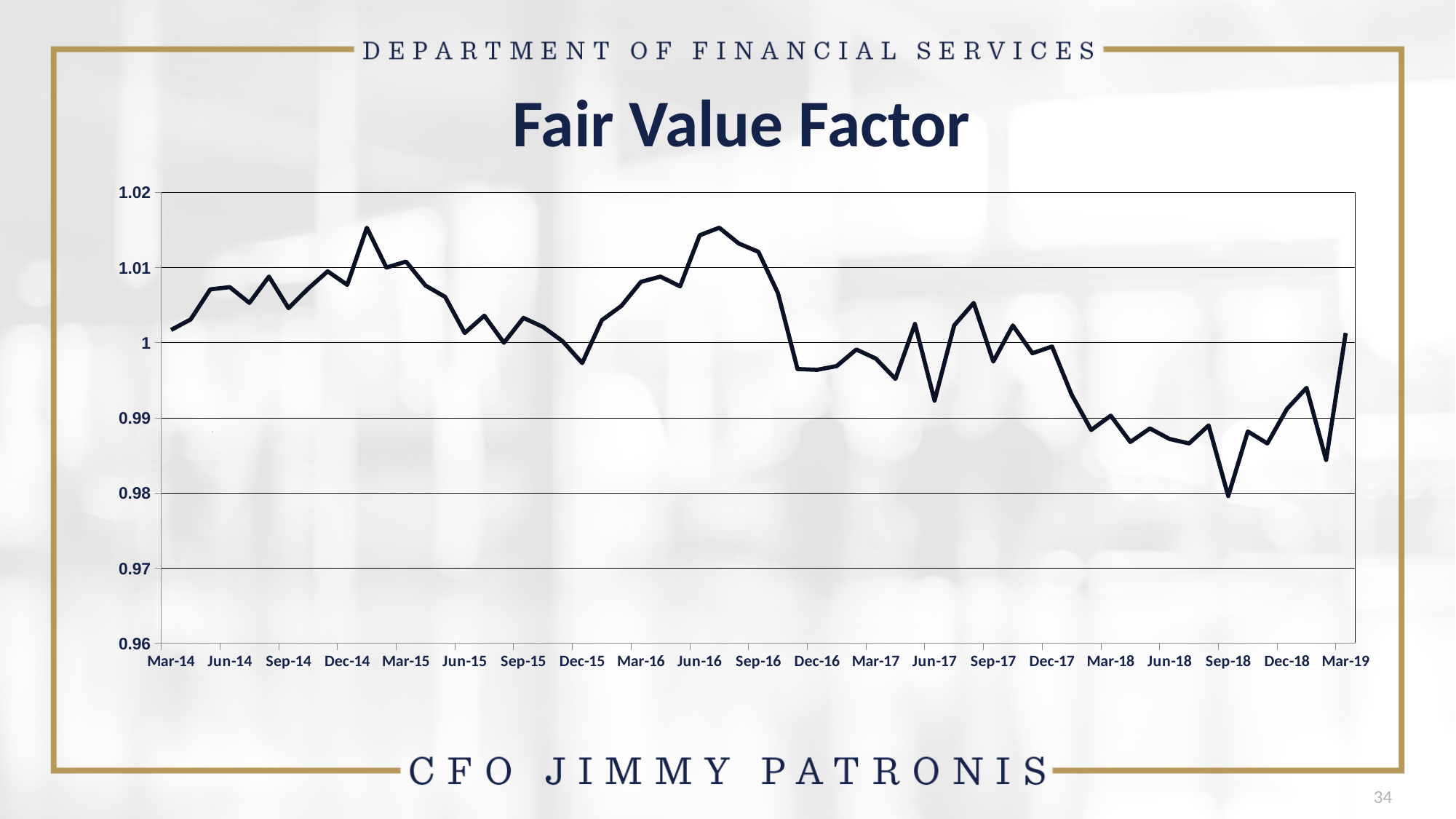
Is the value at Jun-16 greater or less than 1.01? greater Which x-axis label marks the lowest point of the line? Sep-18 Which is larger, the value at Dec-14 or the value at Sep-18? Dec-14 What are the lowest and highest values shown on the y axis? 0.96 and 1.02 What kind of chart is shown on the slide? line chart Is the value at Dec-14 greater or less than 1.01? less Which is larger, the value at Jun-16 or the value at Dec-18? Jun-16 Does the line generally rise or fall between Jun-16 and Sep-18? fall Is the value at Sep-18 greater or less than 0.99? less What is the title of the chart? Fair Value Factor How many date labels are shown along the x axis of the chart? 21